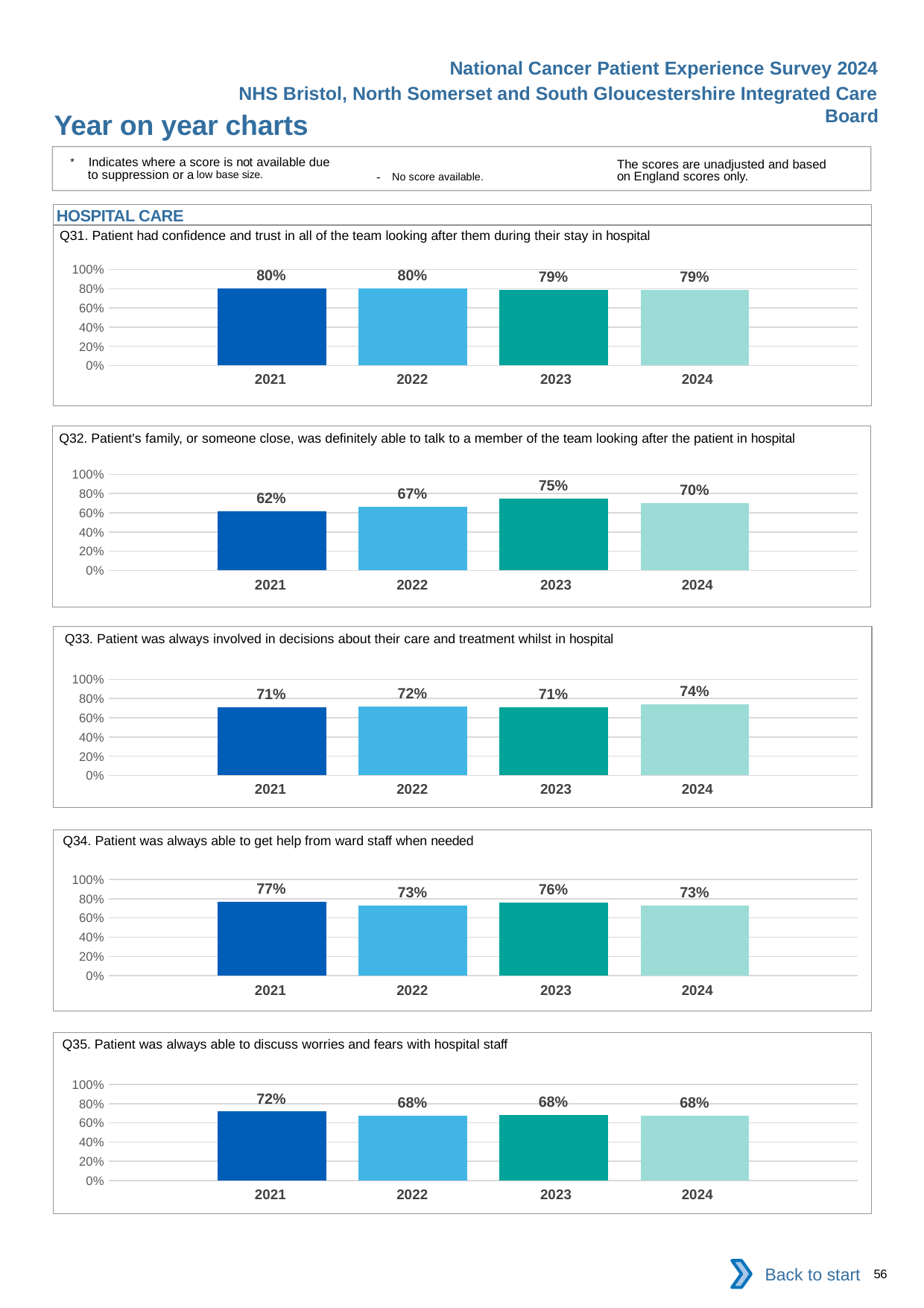
What kind of chart is the Q33 chart? bar chart In the Q32 chart, which year has the lowest value? 2021 In the Q31 chart, do the values rise or fall from 2021 to 2024? fall In the Q32 chart, what is the difference between the 2023 and 2021 values? 13% In the Q35 chart, what is the value for 2021? 72% In the Q31 chart, what is the value for 2021? 80% In the Q33 chart, what is the value for 2024? 74% In the Q35 chart, is the value for 2022 greater or less than 60%? greater In the Q34 chart, which is larger, the value for 2021 or the value for 2022? 2021 In the Q32 chart, which year has the highest value? 2023 How many years are shown in the Q31 chart? 4 In the Q34 chart, what is the difference between the 2021 and 2024 values? 4%